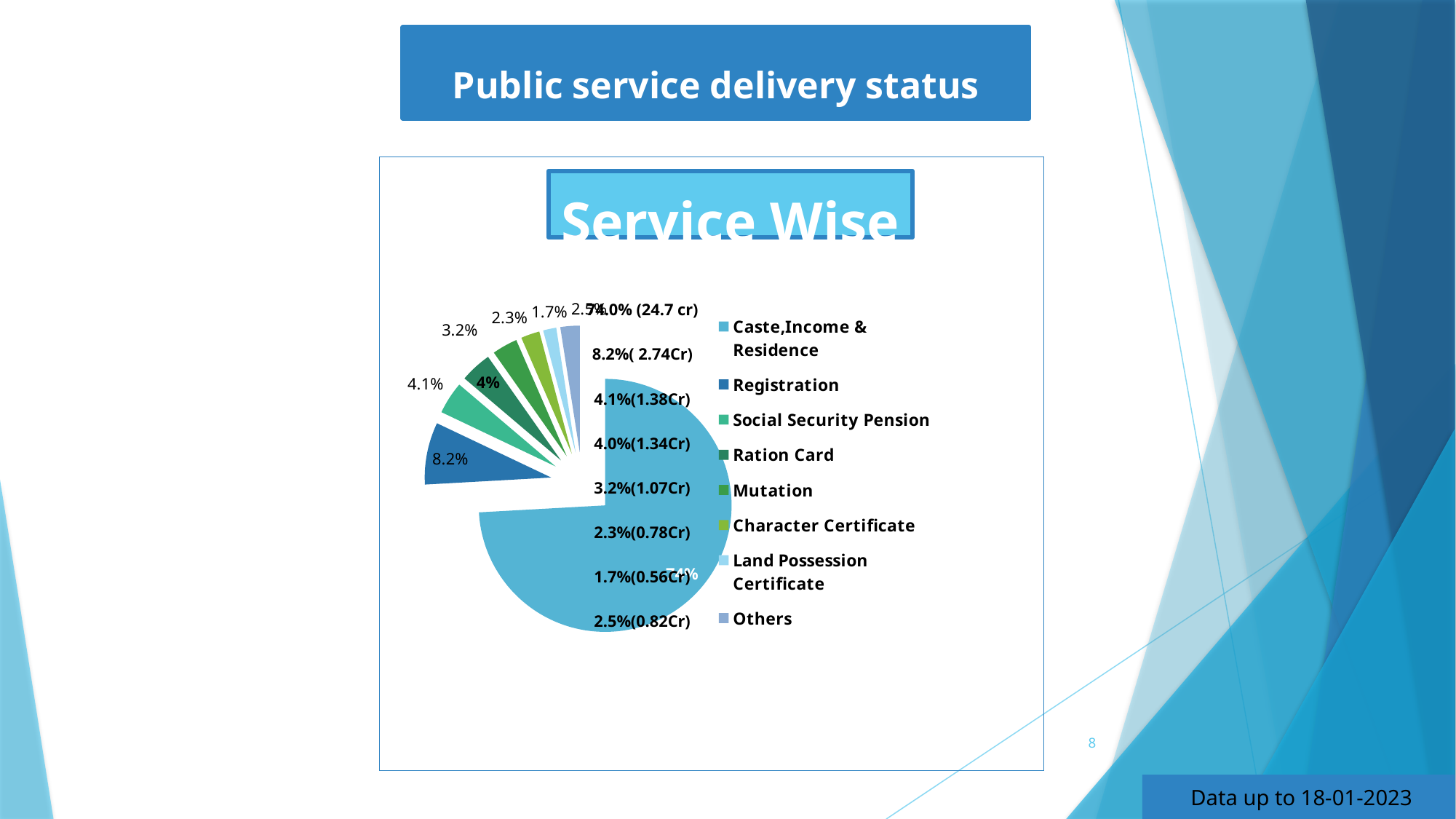
Which category has the smallest share of the pie? Land Possession Certificate Which has a larger share, Character Certificate or Others? Others How many categories does the chart's legend list? 8 What kind of chart is shown on the slide? pie chart Which category has the largest share of the pie? Caste,Income & Residence What is the difference in percentage points between the Registration share and the Social Security Pension share? 4.1 What percentage share does the Land Possession Certificate slice have? 1.7% What percentage share does the Mutation slice have? 3.2% What percentage share does the Registration slice have? 8.2% What percentage share does the Others slice have? 2.5% What is the title of the chart? Service Wise What percentage share does the Social Security Pension slice have? 4.1%